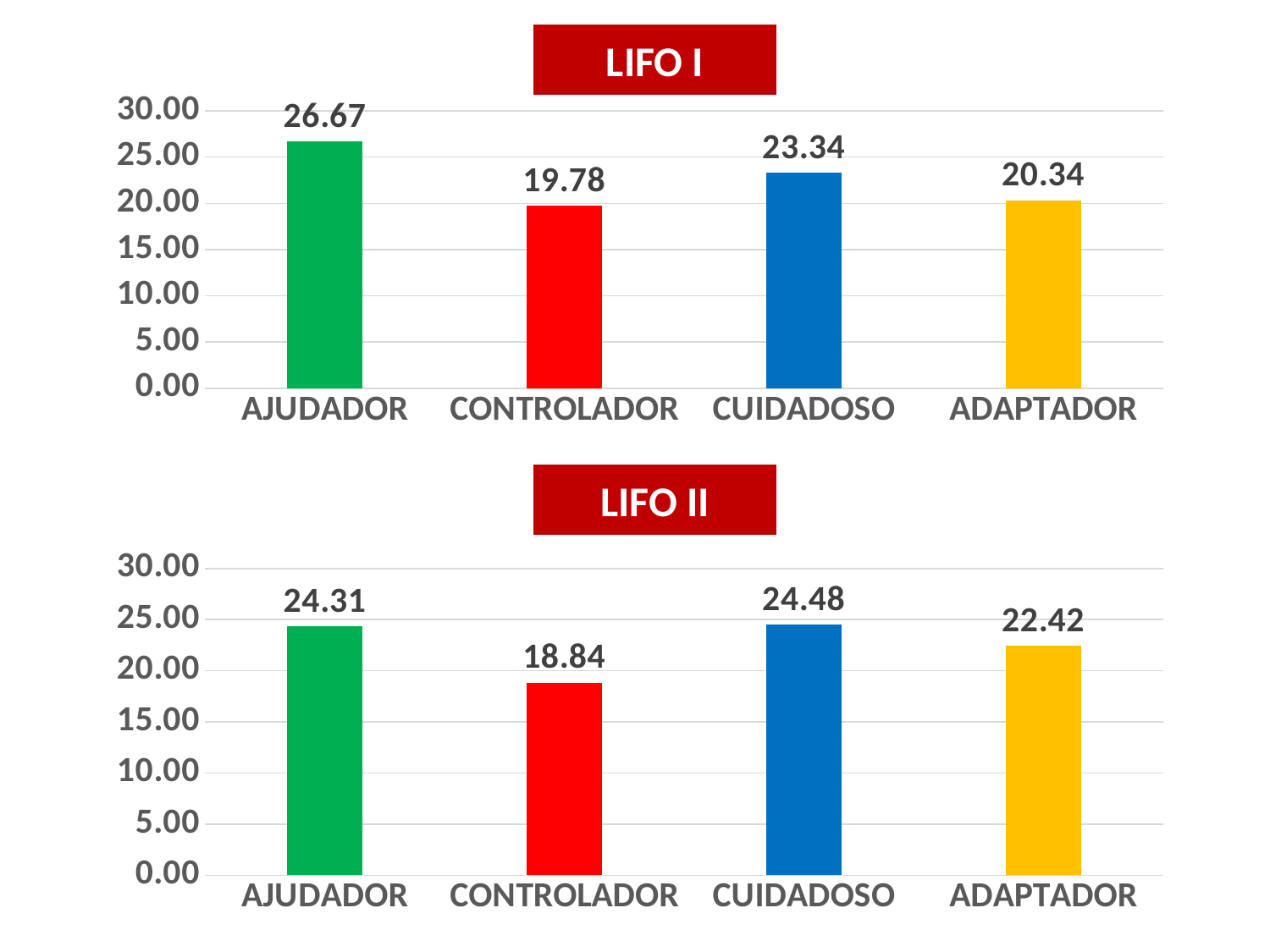
In the LIFO II chart, what is the value for CONTROLADOR? 18.84 In the LIFO II chart, is the value for CONTROLADOR greater or less than 20.00? less In the LIFO II chart, which category has the lowest value? CONTROLADOR In the LIFO II chart, what is the value for ADAPTADOR? 22.42 In the LIFO I chart, which category has the highest value? AJUDADOR In the LIFO I chart, what is the value for CONTROLADOR? 19.78 In the LIFO II chart, what is the difference between the values for CUIDADOSO and ADAPTADOR? 2.06 In the LIFO I chart, what is the value for AJUDADOR? 26.67 In the LIFO I chart, which is larger, the value for CUIDADOSO or the value for ADAPTADOR? CUIDADOSO What kind of chart is the LIFO II chart? bar chart In the LIFO I chart, what is the difference between the values for AJUDADOR and CONTROLADOR? 6.89 How many categories are shown in the LIFO I chart? 4